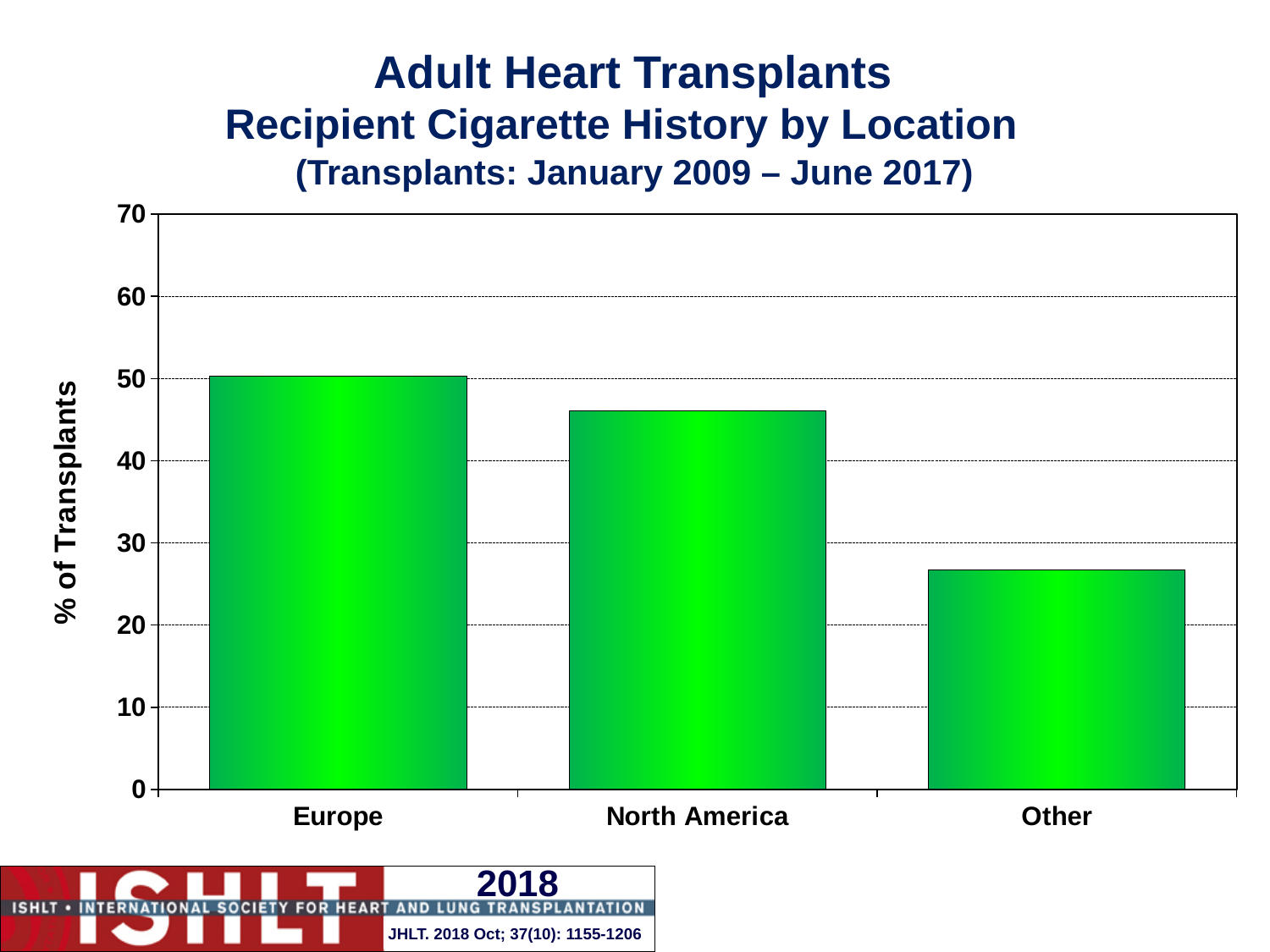
Is the value for North America greater or less than 40? greater What kind of chart is shown on the slide? bar chart What is the label of the y axis? % of Transplants Do the values rise or fall from Europe to Other along the x axis? fall How many locations are shown on the chart? 3 Which is larger, the value for North America or the value for Other? North America Which is larger, the value for Europe or the value for Other? Europe Is the value for Other greater or less than 30? less Which location has the highest % of transplants? Europe Is the value for North America greater or less than 50? less Which location has the lowest % of transplants? Other